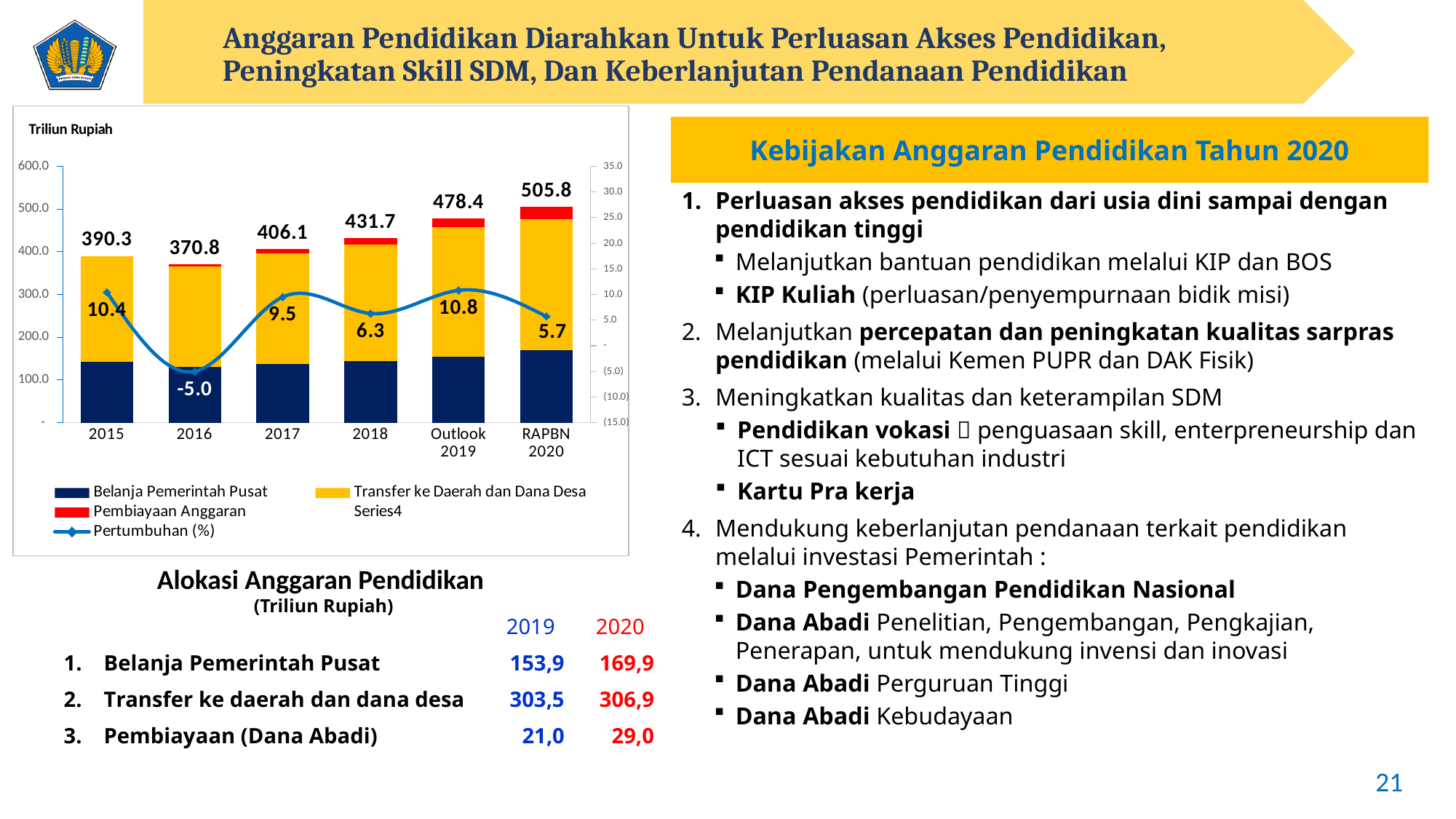
Do the total bar values rise or fall from 2016 to RAPBN 2020? rise Which year has the lowest total education budget in the chart? 2016 How many categories are shown on the x axis of the chart? 6 Is the Belanja Pemerintah Pusat value for 2015 greater or less than 200.0? less What is the total education budget label shown for RAPBN 2020? 505.8 What is the difference between the total for RAPBN 2020 and the total for Outlook 2019? 27.4 Which year shows the lowest growth percentage on the Pertumbuhan (%) line? 2016 What growth percentage (Pertumbuhan) is shown for 2016? -5.0 How many entries does the chart legend list? 5 Which category has the highest total value in the chart? RAPBN 2020 Which is larger, the total for 2017 or the total for 2018? 2018 What is the total value labeled above the bar for Outlook 2019? 478.4